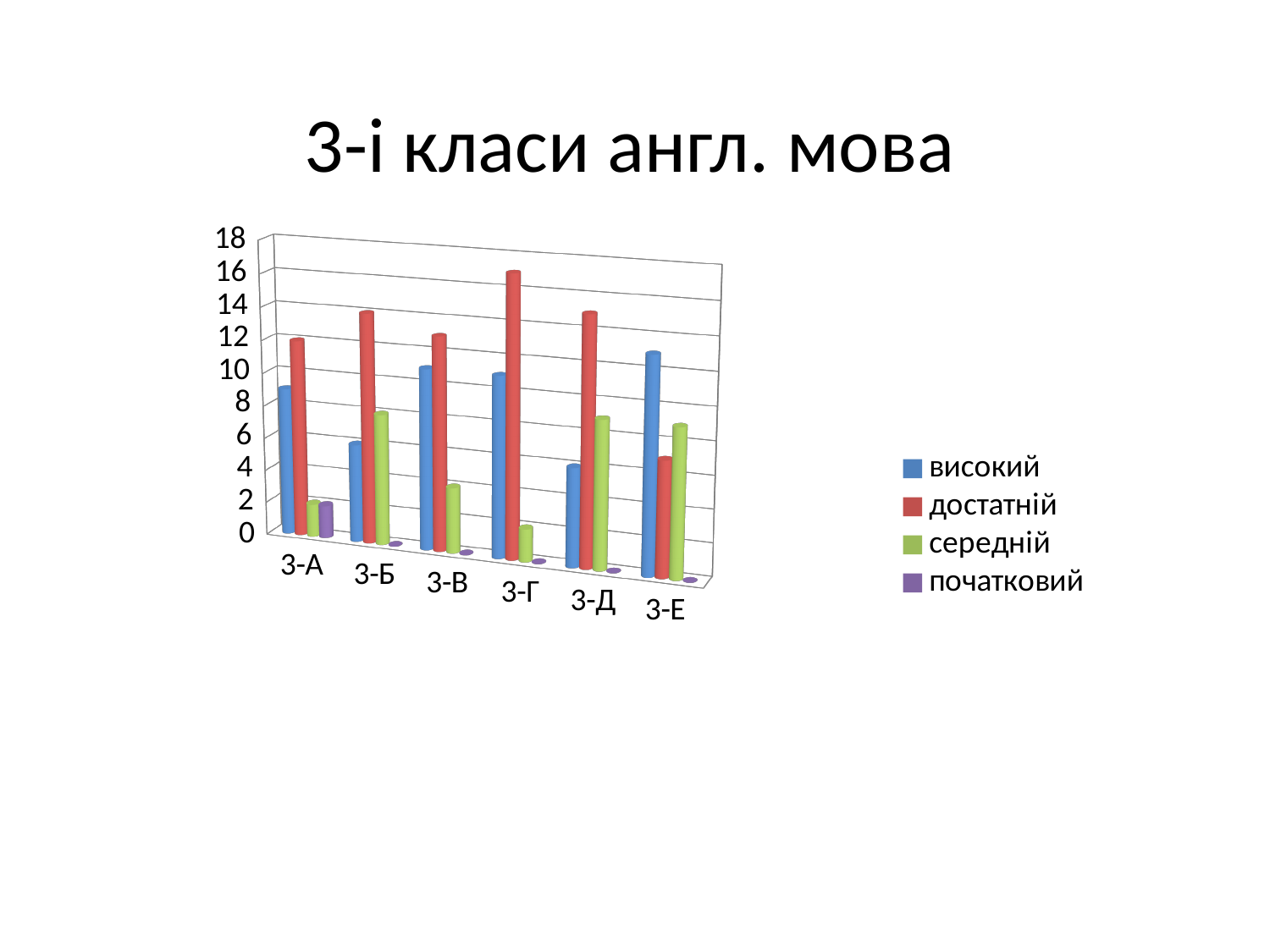
Is the value for високий in 3-Е greater or less than 8? greater Which class has the highest value for високий? 3-Е How many series does the legend list? 4 What is the title of the chart? 3-і класи англ. мова What kind of chart is shown on the slide? bar chart How many classes (categories) are shown on the x axis? 6 Which legend entry is shown in purple? початковий Is the value for середній in 3-А greater or less than 4? less Is the value for достатній in 3-Г greater or less than 14? greater Which is larger: достатній for 3-Г or достатній for 3-А? достатній for 3-Г Which class has the highest value for достатній? 3-Г